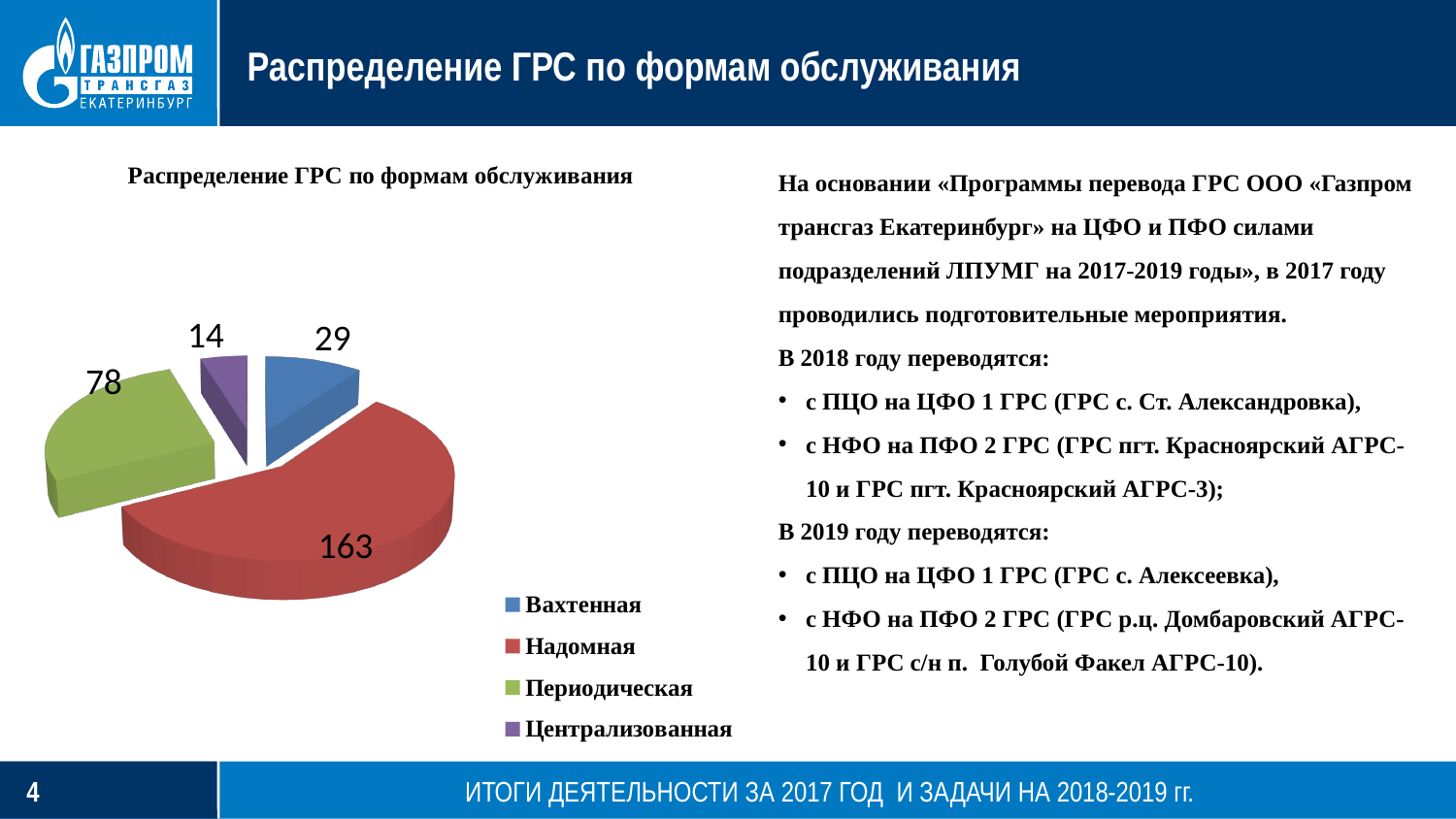
What is the total of all slices in the pie chart? 284 What is the value for Вахтенная in the pie chart? 29 How many categories does the pie chart show? 4 Which category has the smallest slice in the pie chart? Централизованная What type of chart is shown on the slide? Pie chart What is the value for Периодическая in the pie chart? 78 What is the title of the pie chart? Распределение ГРС по формам обслуживания What is the difference between the values for Надомная and Периодическая? 85 What is the value for Централизованная in the pie chart? 14 Which is larger, the value for Вахтенная or the value for Централизованная? Вахтенная Which category has the largest slice in the pie chart? Надомная What is the value for Надомная in the pie chart? 163